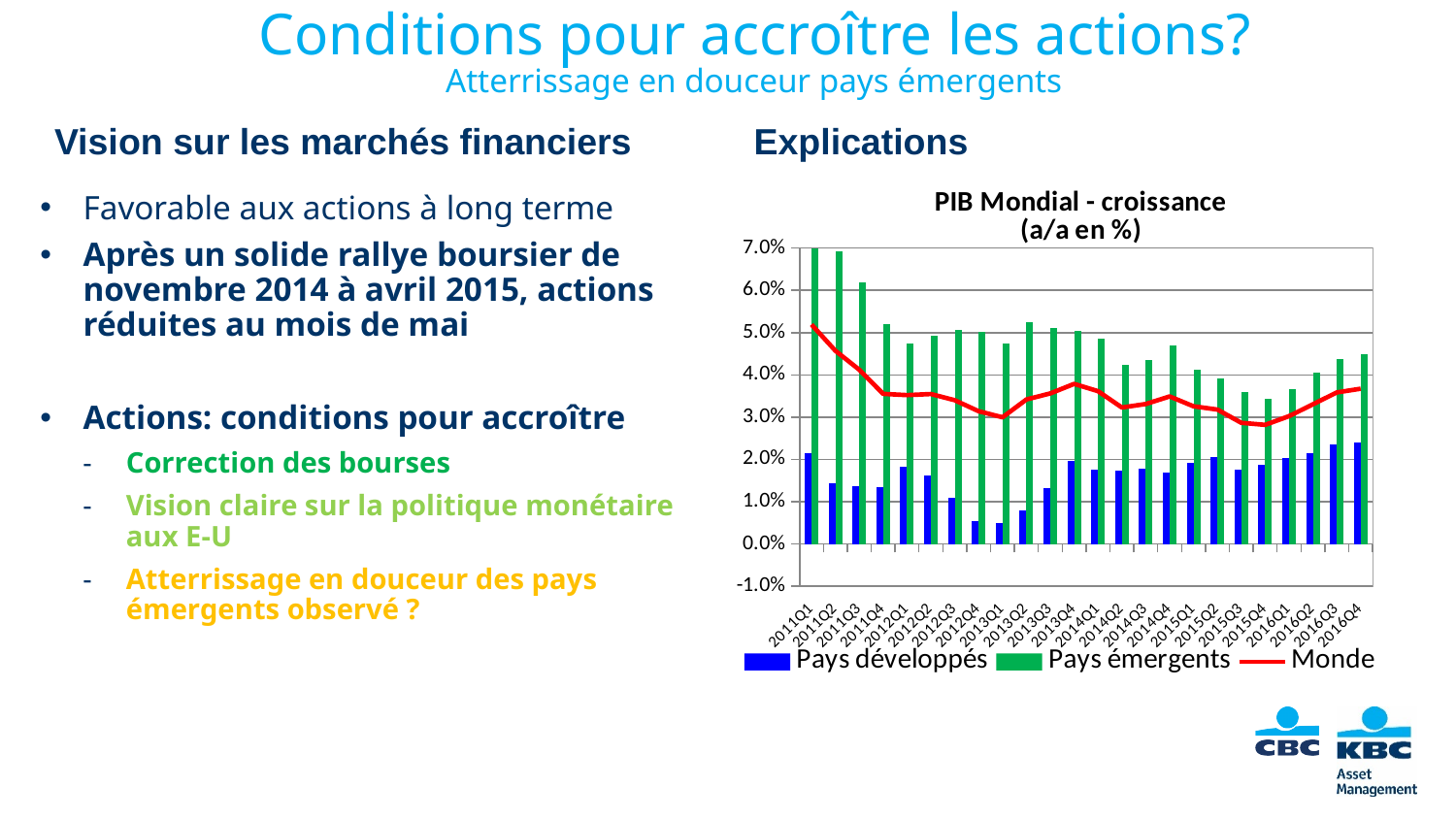
What is the title of the chart on the slide? PIB Mondial - croissance (a/a en %) Which series is drawn as a red line in the chart? Monde What kind of chart is shown on the slide? Bar chart with a line series How many quarters are shown along the x axis of the chart? 24 Is the value for Pays développés in 2013Q1 greater or less than 1.0%? less How many series does the chart legend list? 3 Is the value for Monde in 2011Q1 greater or less than 4.0%? greater Is the value for Monde in 2015Q4 greater or less than 4.0%? less In 2011Q1, which is larger: Pays développés or Pays émergents? Pays émergents Do the Pays émergents values generally rise or fall from 2011Q1 to 2013Q1? fall In which quarter is the Pays émergents bar the highest? 2011Q1